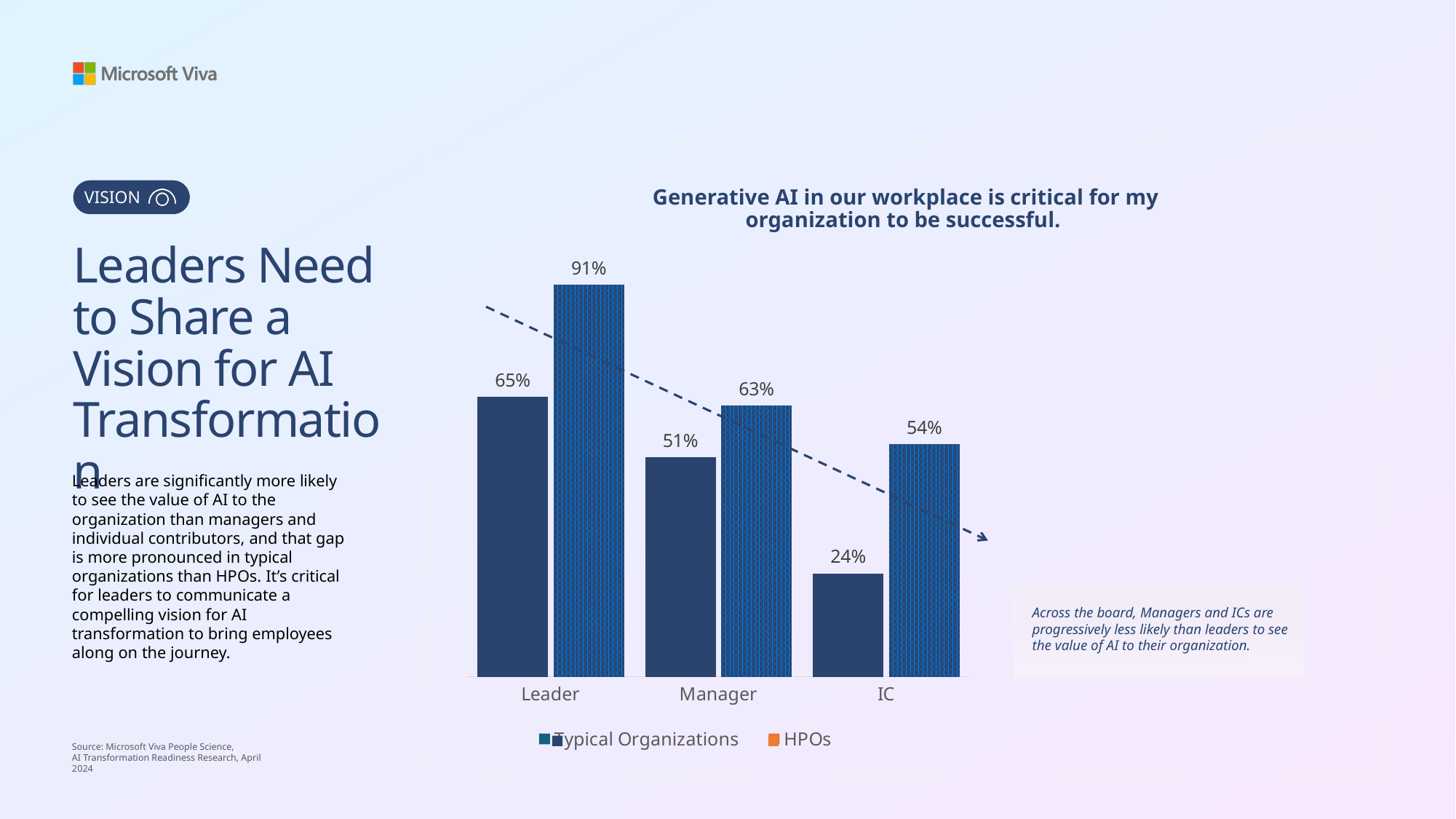
What is the difference between the HPOs and Typical Organizations values in the IC category? 30% Which category has the highest value for HPOs? Leader How many categories are shown on the x axis? 3 Which is larger in the Manager category: Typical Organizations or HPOs? HPOs Which category has the lowest value for Typical Organizations? IC What is the value for Typical Organizations in the IC category? 24% What kind of chart is shown on the slide? Bar chart What is the value for HPOs in the Leader category? 91% How many series does the legend list? 2 What is the value for HPOs in the Manager category? 63% Do the Typical Organizations values rise or fall from Leader to IC? Fall What is the value for Typical Organizations in the Leader category? 65%